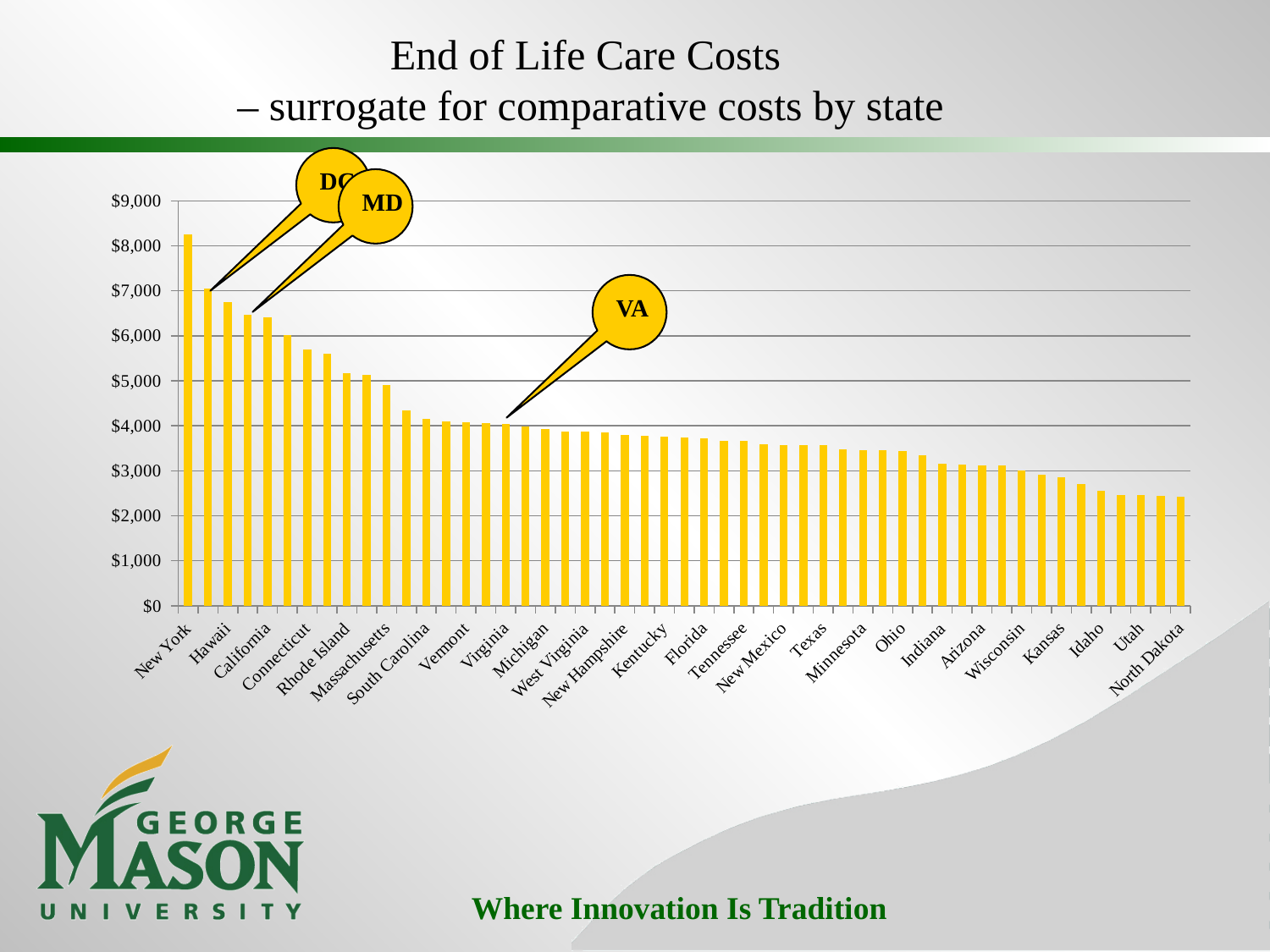
Is the value for Texas greater or less than $4,000? less Is the value for New York greater or less than $7,000? greater Which three states are highlighted with callout labels on the chart? DC, MD, VA Is the value for Rhode Island greater or less than $5,000? greater Do the values rise or fall moving from left to right along the x axis? fall Which has the larger value, California or Texas? California What kind of chart is shown on the slide? bar chart Which state has the highest end of life care cost in the chart? New York